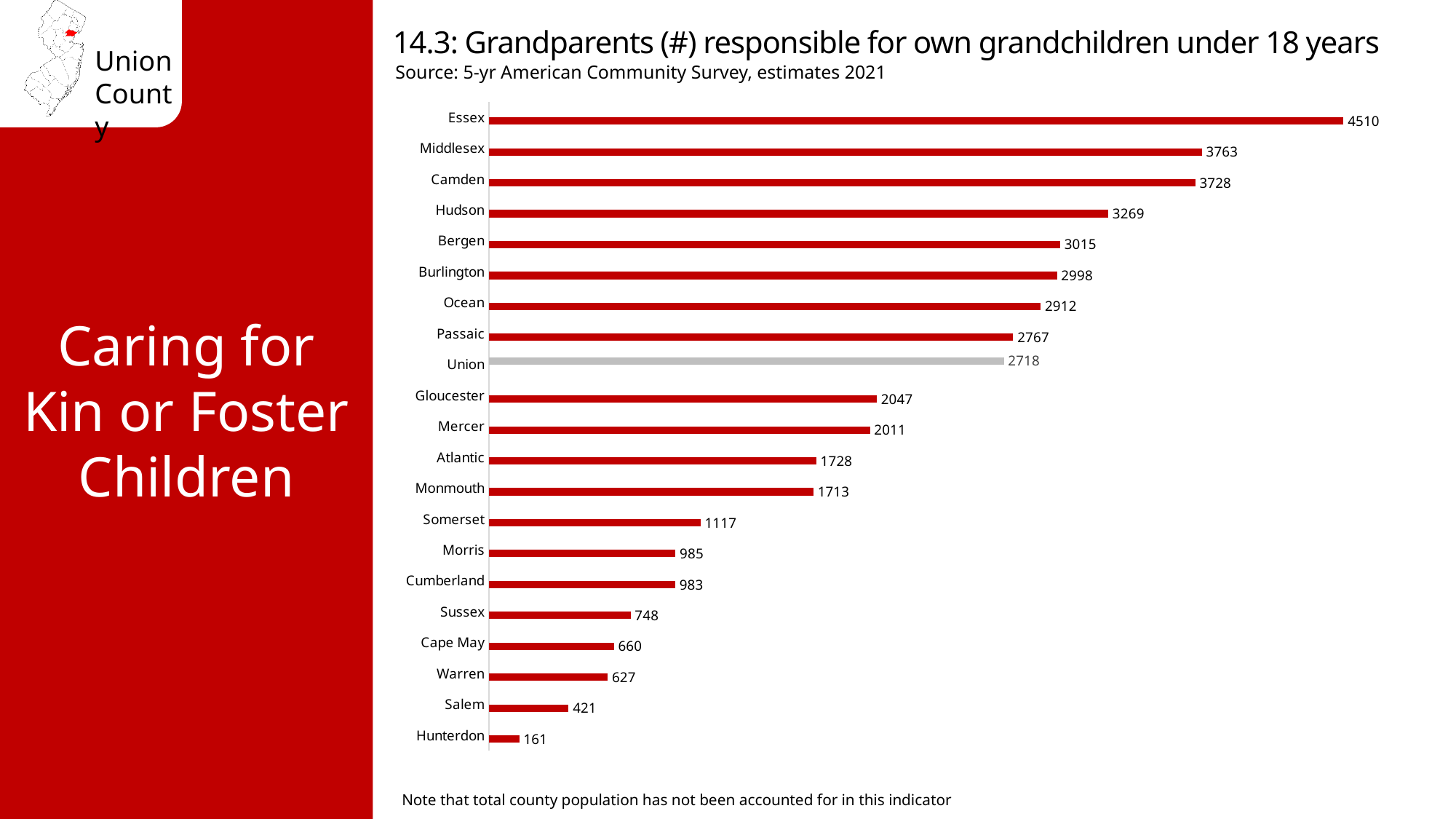
What kind of chart is shown on the slide? Bar chart How many counties are shown in the chart? 21 What is the value for Union? 2718 What is the difference between the values for Passaic and Union? 49 Which bar is shown in grey rather than red? Union What is the value for Hudson? 3269 Which is larger, the value for Gloucester or the value for Somerset? Gloucester Which county has the lowest value? Hunterdon Which county has the highest value? Essex What is the difference between the values for Essex and Middlesex? 747 What is the source of the data shown in the chart? 5-yr American Community Survey, estimates 2021 What is the value for Cape May? 660